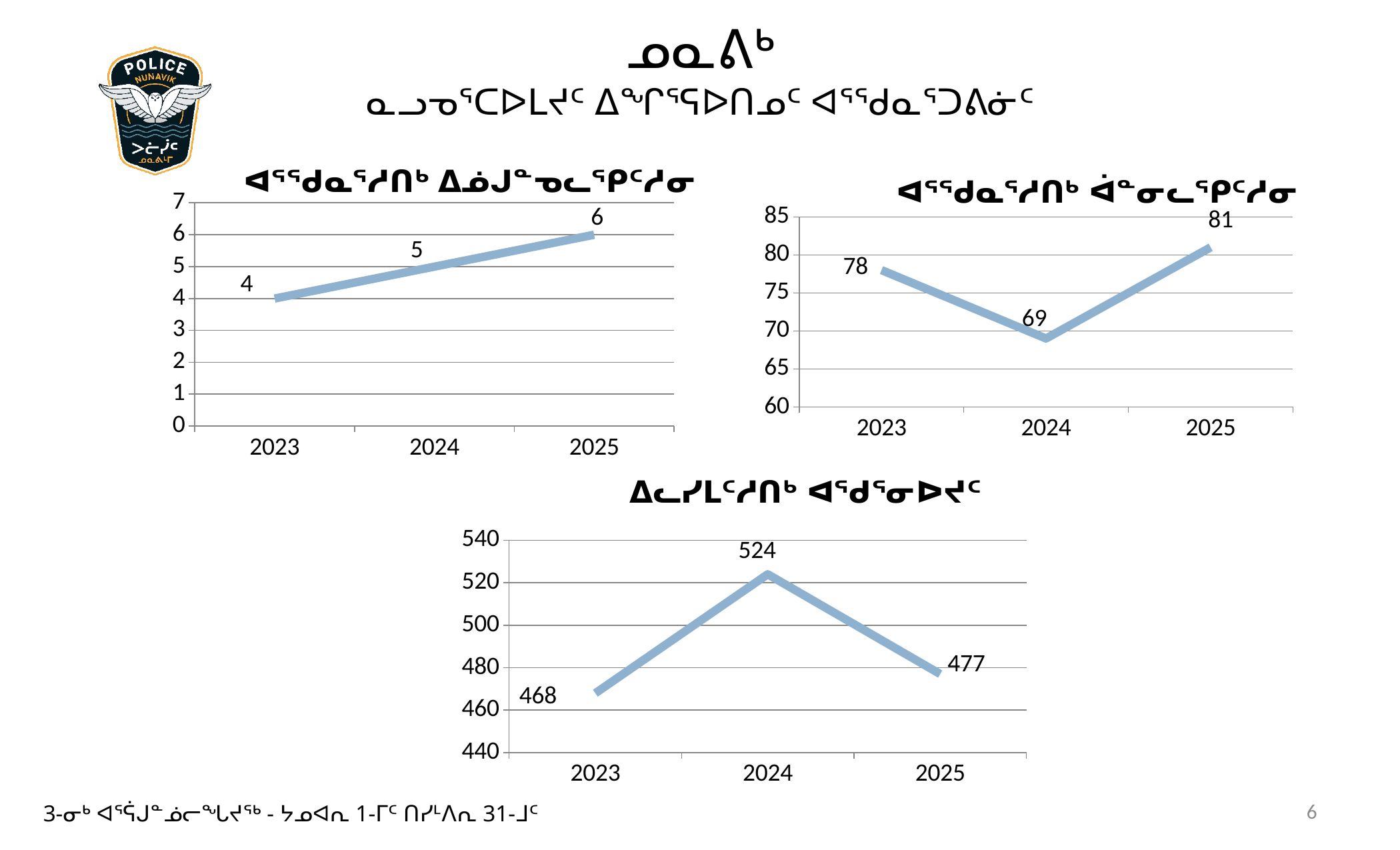
In the top-left chart, do the values rise or fall from 2023 to 2025? rise In the bottom chart, is the value for 2023 larger or smaller than the value for 2025? smaller In the bottom chart, what is the difference between the 2024 value and the 2025 value? 47 In the top-right chart, what is the value for 2024? 69 In the bottom chart, what is the value for 2024? 524 In the top-left chart, what is the value for 2025? 6 In the top-right chart, which year has the lowest value? 2024 In the top-right chart, which year has the highest value? 2025 In the top-right chart, what is the difference between the 2025 value and the 2023 value? 3 In the top-left chart, what is the value for 2023? 4 What kind of chart is the bottom chart? line chart In the bottom chart, which year has the lowest value? 2023